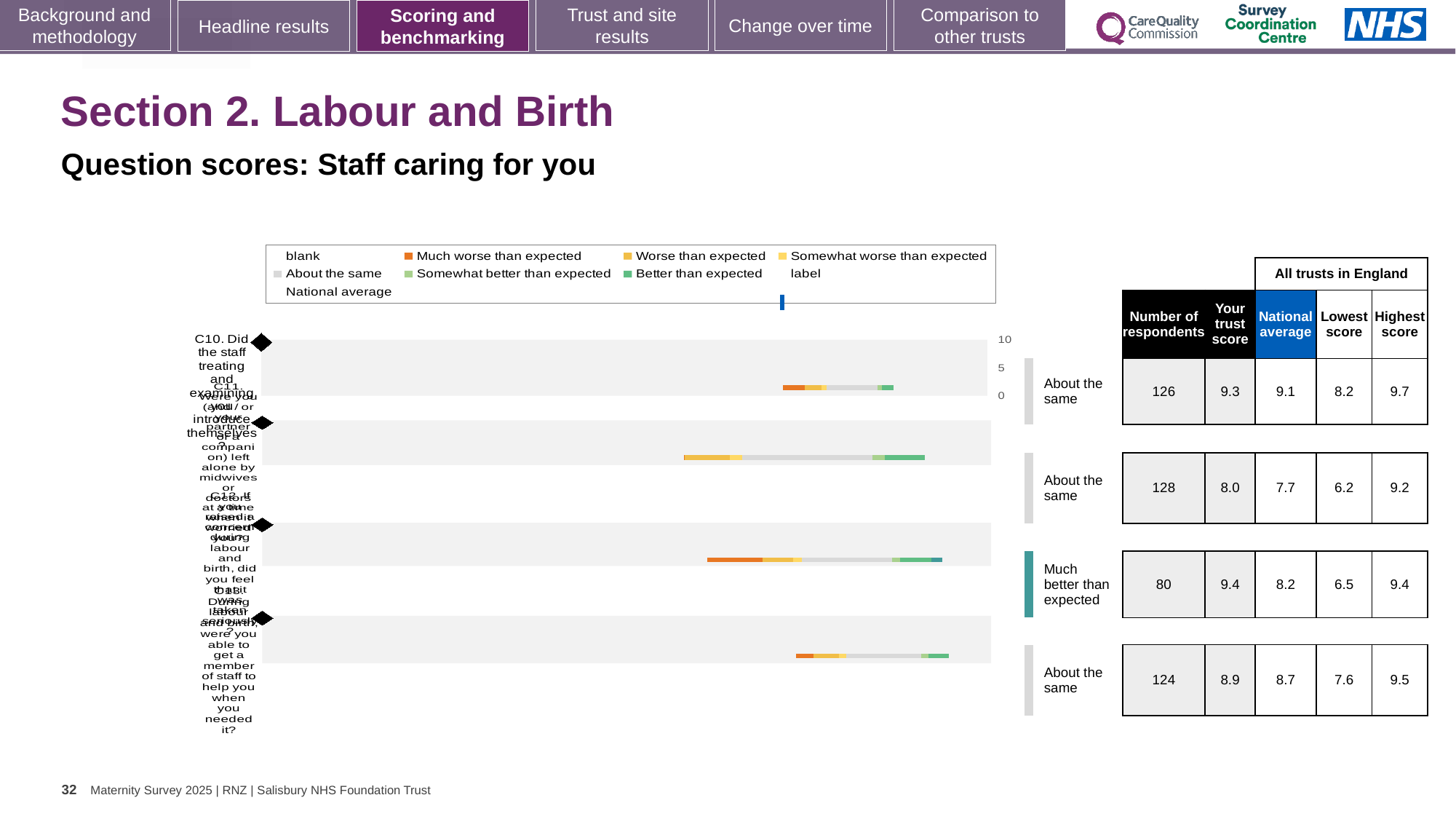
Which row is rated 'Much better than expected'? C12 (third row) How many respondents are listed for the third row (C12)? 80 What is the difference between the trust score and the national average for the third row (C12)? 1.2 What kind of chart is shown on the slide? bar chart How many survey questions (rows) are plotted in the chart? 4 What is the highest score across all trusts in England for the fourth row (C13)? 9.5 Which row has the lowest 'Your trust score'? C11 (second row), 8.0 For the first row (C10), which is larger: the trust score or the national average? the trust score (9.3) What is the national average for the second row (C11)? 7.7 Which row has the highest 'Your trust score'? C12 (third row), 9.4 What is the trust score for the first row (C10) in the table beside the chart? 9.3 What is the subtitle of the chart on this slide? Question scores: Staff caring for you